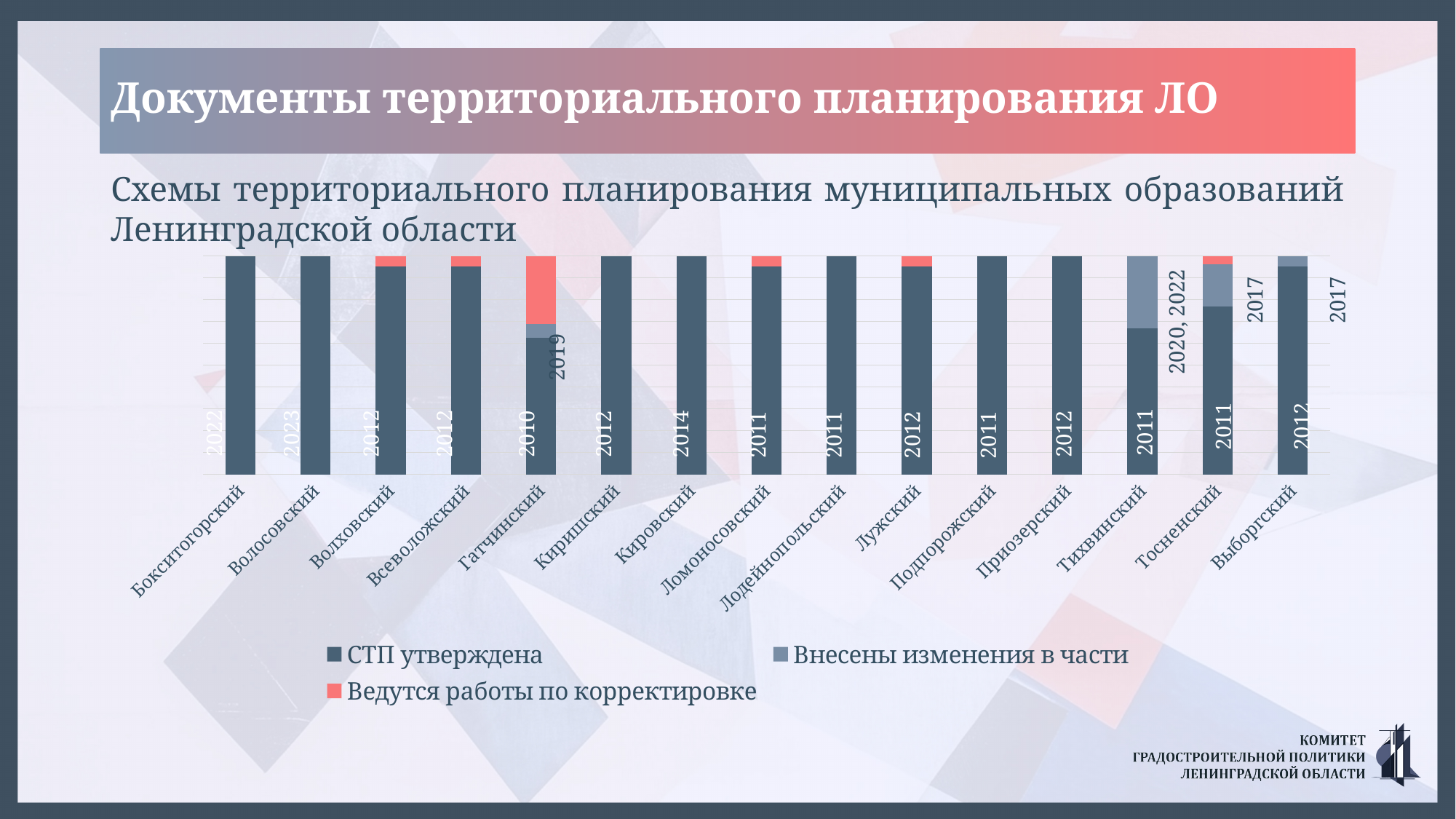
How many municipal districts (categories) are shown along the x axis of the chart? 15 What year label is printed on the dark 'СТП утверждена' segment of the Гатчинский bar? 2010 What year is printed on the bar for Волосовский? 2023 What year labels are printed next to the 'Внесены изменения в части' segment of the Тихвинский bar? 2020, 2022 How many series does the chart legend list? 3 What year label is printed next to the 'Внесены изменения в части' segment of the Гатчинский bar? 2019 What kind of chart is shown on the slide? Stacked bar chart What year is printed on the bar for Бокситогорский? 2022 What year is printed on the bar for Кировский? 2014 What year is printed next to the 'Внесены изменения в части' segment of the Выборгский bar? 2017 Which district has the largest red 'Ведутся работы по корректировке' segment in its bar? Гатчинский Which legend entry is shown in red (coral) colour? Ведутся работы по корректировке